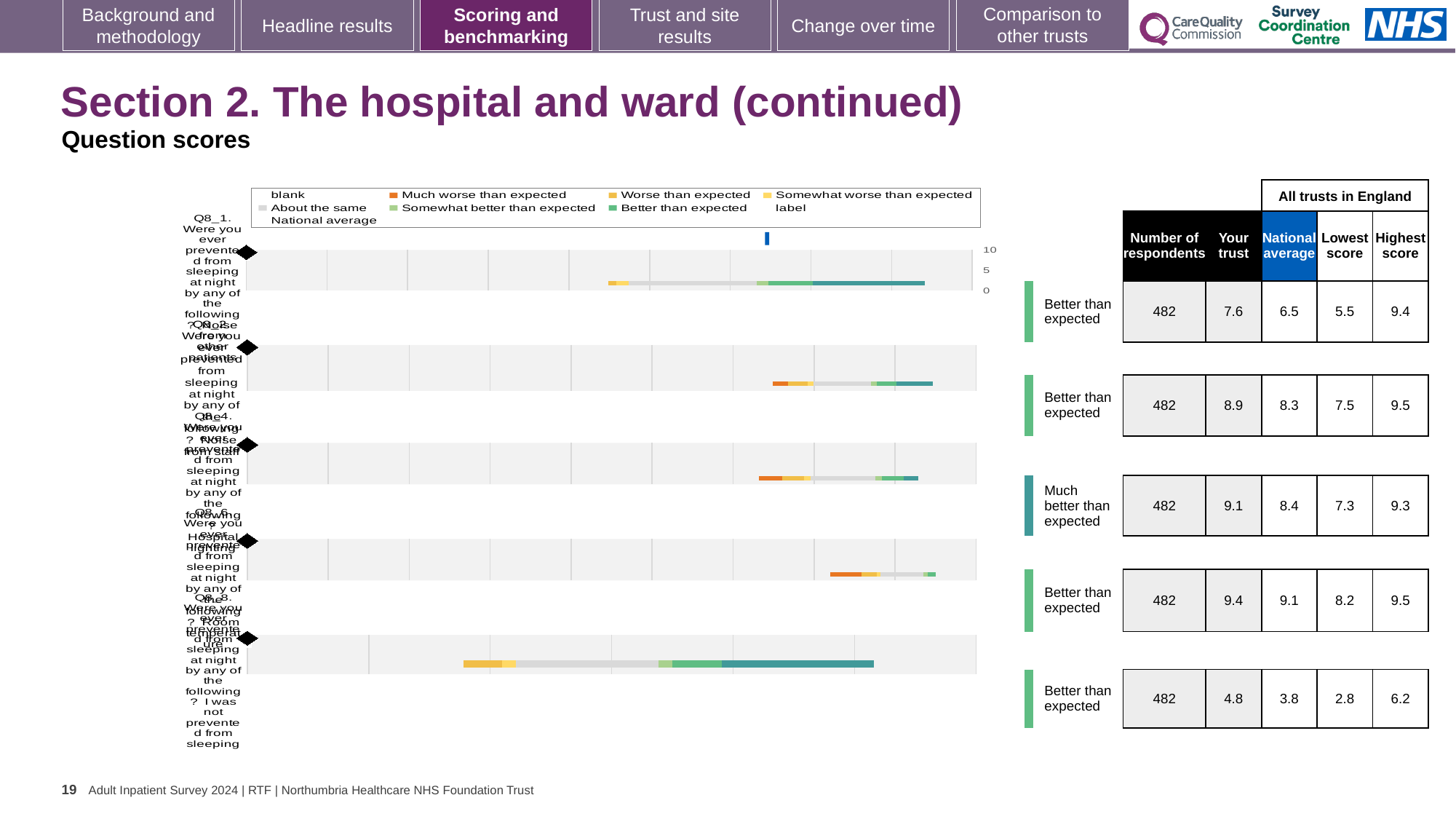
Which question row has the highest 'Your trust' score in the table beside the chart? Q8_6 How many question rows (bars) are plotted in the chart? 5 How many respondents are listed for each question row in the table beside the chart? 482 According to the table beside the chart, what is the 'Your trust' score for Q8_1 (the first row)? 7.6 In the chart legend, what colour represents 'Much worse than expected'? Orange For Q8_2 (the second row), which is larger: the 'Your trust' score or the national average? Your trust According to the table beside the chart, what is the national average for Q8_8 (the last row)? 3.8 For Q8_1 (the first row), what is the difference between the 'Your trust' score and the national average? 1.1 Which question row has the lowest 'Your trust' score in the table beside the chart? Q8_8 What benchmark rating is shown for Q8_4 (the third row)? Much better than expected In the chart legend, what colour represents 'Better than expected'? Teal What kind of chart is shown on the slide? Bar chart